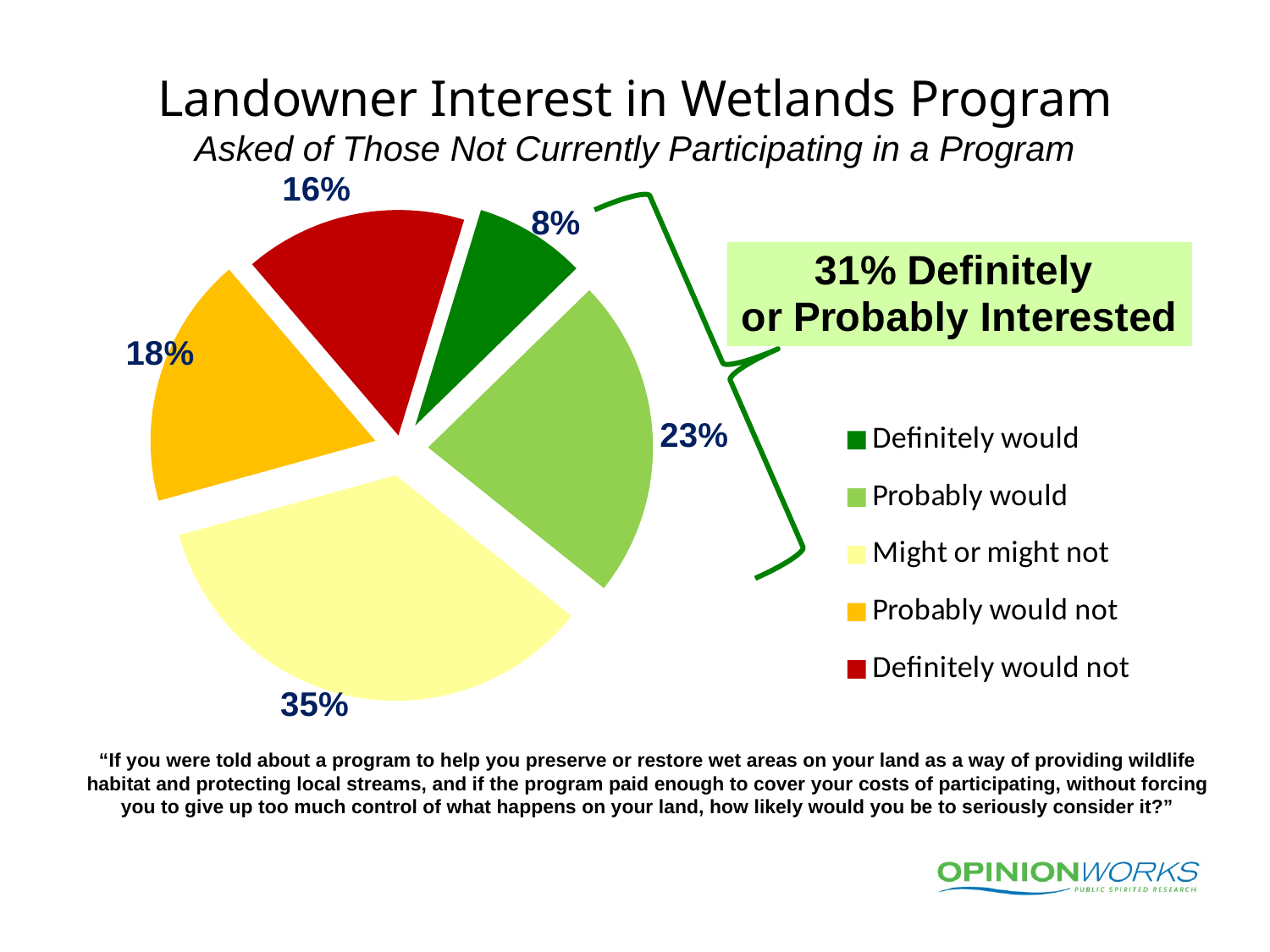
What percentage of landowners said they "Definitely would not" consider the program? 16% What percentage of landowners said they "Probably would not" consider the program? 18% What percentage of landowners said they "Probably would" consider the program? 23% What percentage of landowners said they "Definitely would" consider the program? 8% What kind of chart is shown on the slide? Pie chart Which response category has the smallest share of the pie? Definitely would What combined percentage does the callout box give for those definitely or probably interested? 31% What is the difference in percentage points between "Probably would" and "Definitely would"? 15 How many response categories does the legend list? 5 Which is larger, the share for "Probably would not" or the share for "Definitely would not"? Probably would not Which response category has the largest share of the pie? Might or might not What percentage of landowners said they "Might or might not" consider the program? 35%